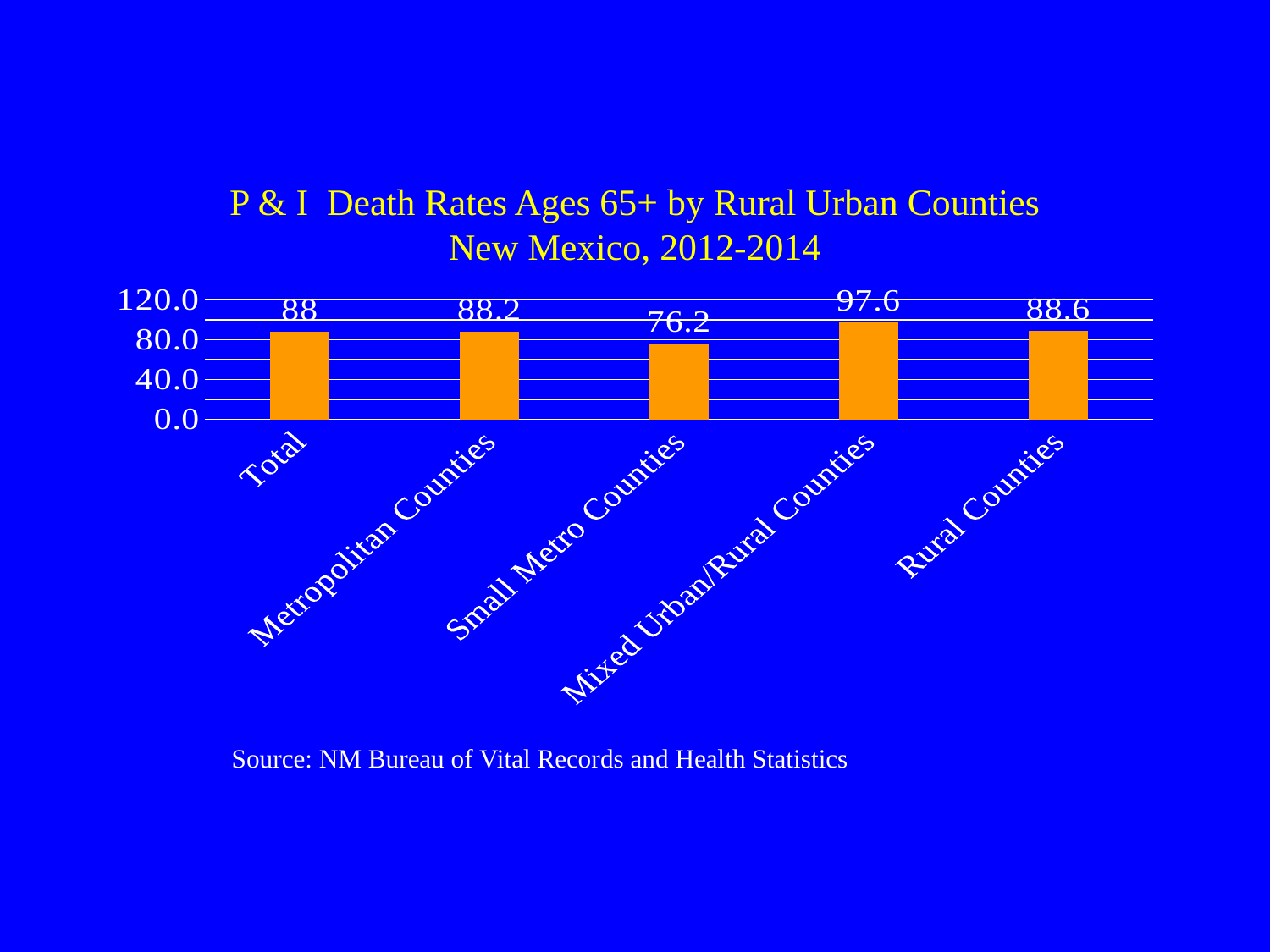
What kind of chart is shown on the slide? Bar chart How many categories are shown on the x axis? 5 What is the difference between the values for Mixed Urban/Rural Counties and Small Metro Counties? 21.4 Which category has the lowest death rate? Small Metro Counties What is the value shown for Small Metro Counties? 76.2 Which category has the highest death rate? Mixed Urban/Rural Counties Is the value for Metropolitan Counties greater or less than 80.0? greater What is the value shown for the Total category? 88 What is the P & I death rate for Mixed Urban/Rural Counties? 97.6 Which is larger, the value for Rural Counties or the value for Small Metro Counties? Rural Counties What is the value shown for Rural Counties? 88.6 What is the source cited below the chart? NM Bureau of Vital Records and Health Statistics